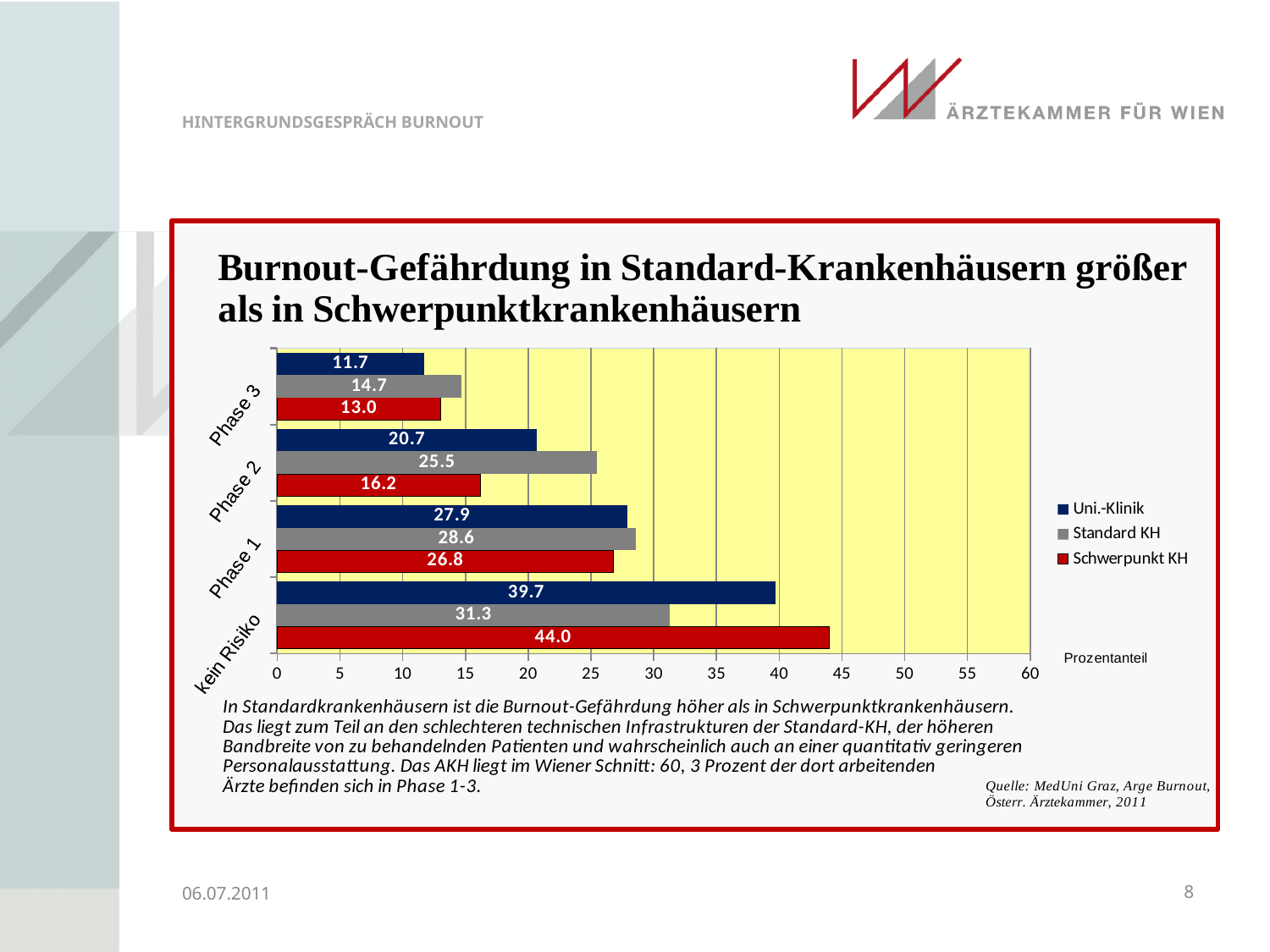
What is the label of the horizontal axis? Prozentanteil How many categories are shown on the vertical axis? 4 Which series has the lowest value in Phase 2? Schwerpunkt KH Which is larger in Phase 3: the Standard KH value or the Schwerpunkt KH value? Standard KH What is the value for Uni.-Klinik in Phase 3? 11.7 What kind of chart is shown on the slide? bar chart What is the value for Schwerpunkt KH in the 'kein Risiko' category? 44.0 How many series does the legend list? 3 What is the value for Standard KH in Phase 2? 25.5 Which series has the highest value in the 'kein Risiko' category? Schwerpunkt KH What is the difference between the Standard KH and Uni.-Klinik values in Phase 2? 4.8 Is the Uni.-Klinik value for 'kein Risiko' greater or less than 35? greater